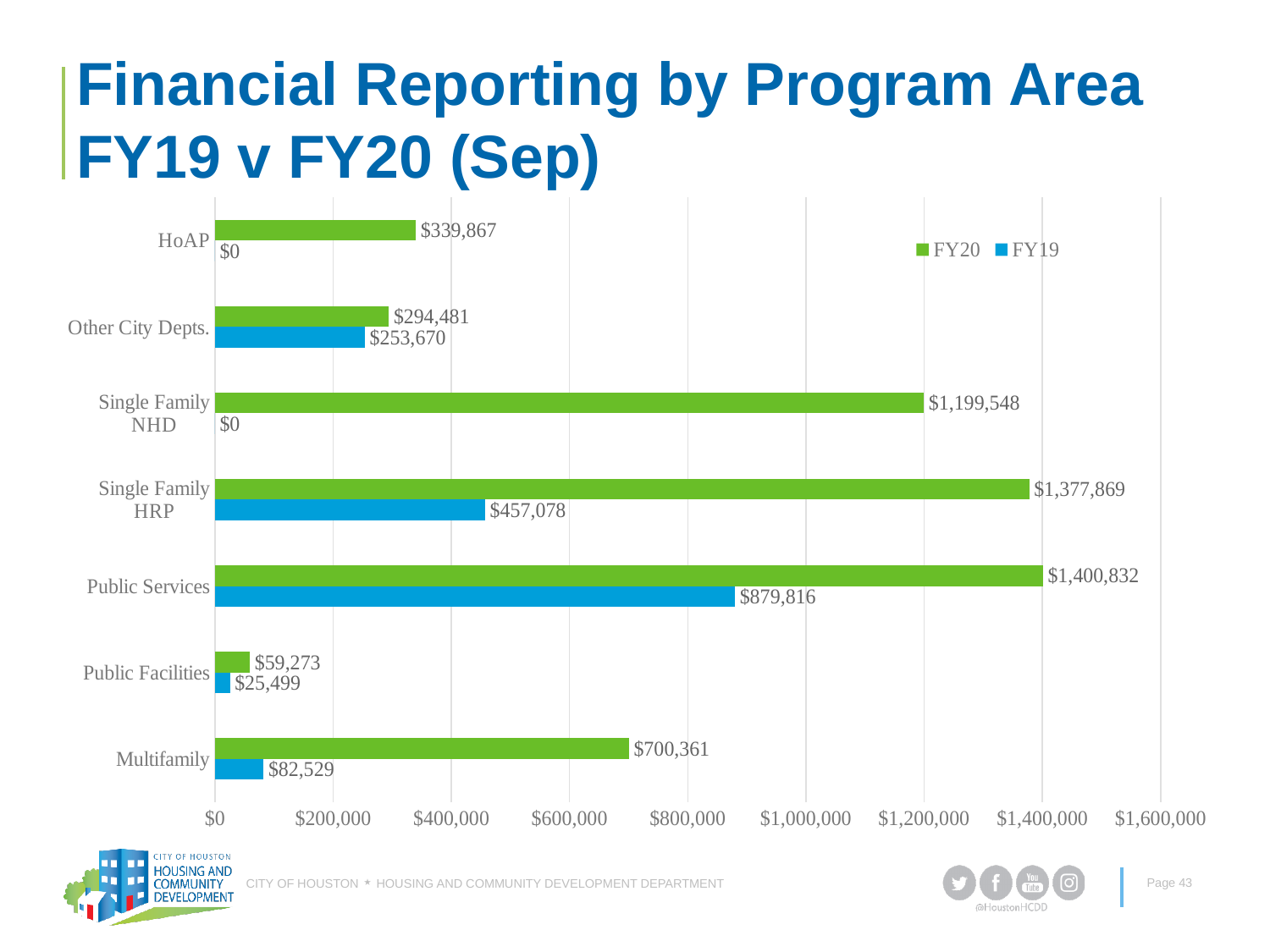
What is the FY19 value for Single Family HRP? $457,078 Which program area has the highest FY19 value? Public Services Which program area has the lowest FY20 value? Public Facilities What is the difference between the FY20 and FY19 values for Public Services? $521,016 Which program area has the highest FY20 value? Public Services Which is larger: the FY20 value for Single Family NHD or the FY20 value for Multifamily? Single Family NHD How many series does the legend list? 2 What is the difference between the FY20 and FY19 values for Multifamily? $617,832 How many program areas are shown on the chart? 7 What is the FY20 value for Multifamily? $700,361 What is the FY20 value for Public Services? $1,400,832 What is the FY19 value for HoAP? $0